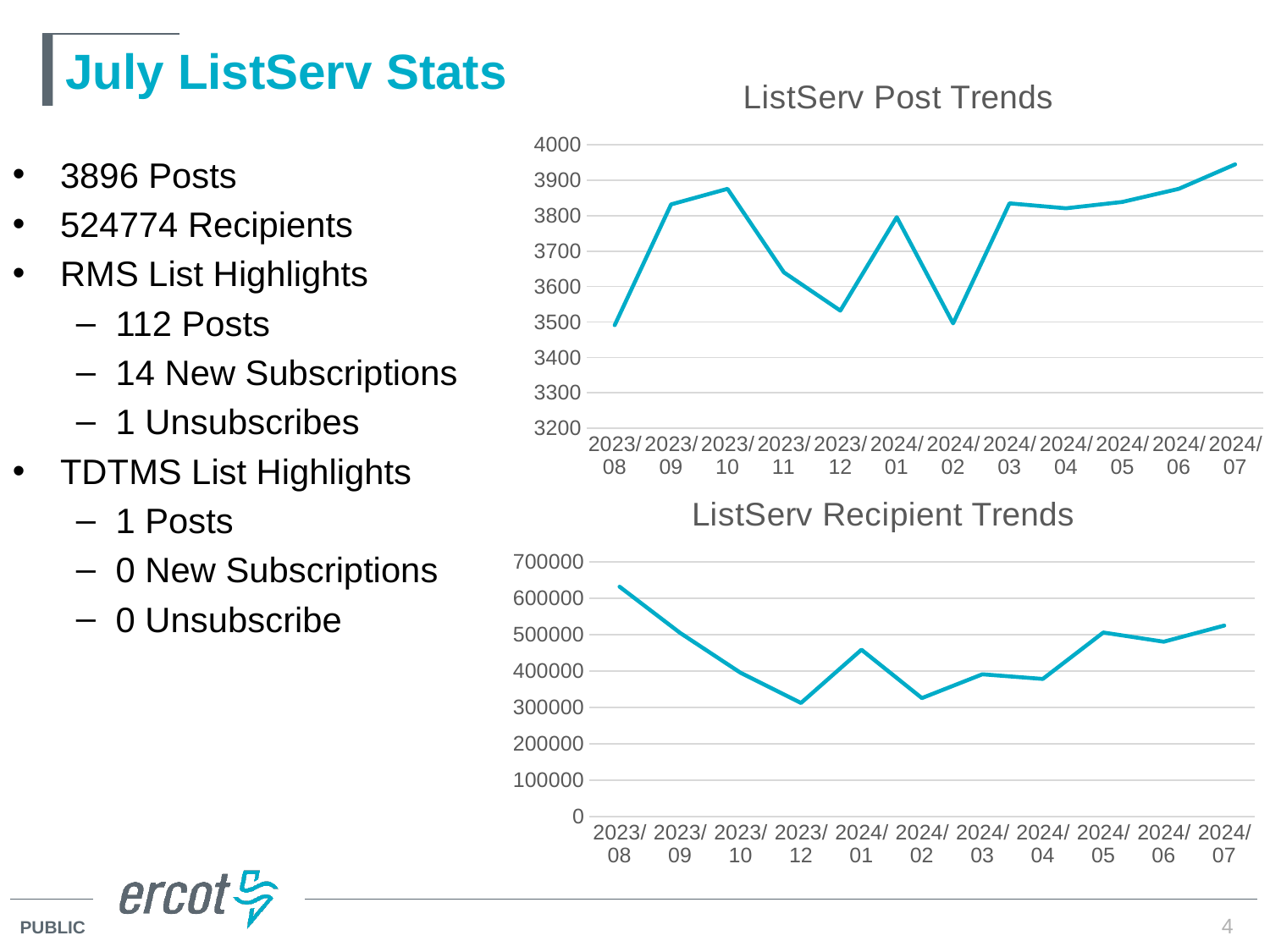
On the ListServ Recipient Trends chart, is the value for 2023/12 greater or less than 400000? less What kind of chart is the ListServ Post Trends chart? line chart On the ListServ Post Trends chart, is the value for 2023/12 greater or less than 3600? less How many data points are plotted on the ListServ Recipient Trends chart? 11 On the ListServ Recipient Trends chart, which month has the highest value? 2023/08 On the ListServ Post Trends chart, is the value for 2024/07 greater or less than 3900? greater How many data points are plotted on the ListServ Post Trends chart? 12 On the ListServ Post Trends chart, which is larger, the value for 2023/09 or the value for 2023/11? 2023/09 On the ListServ Post Trends chart, do the values rise or fall from 2024/02 to 2024/07? rise What kind of chart is the ListServ Recipient Trends chart? line chart On the ListServ Post Trends chart, which month has the highest value? 2024/07